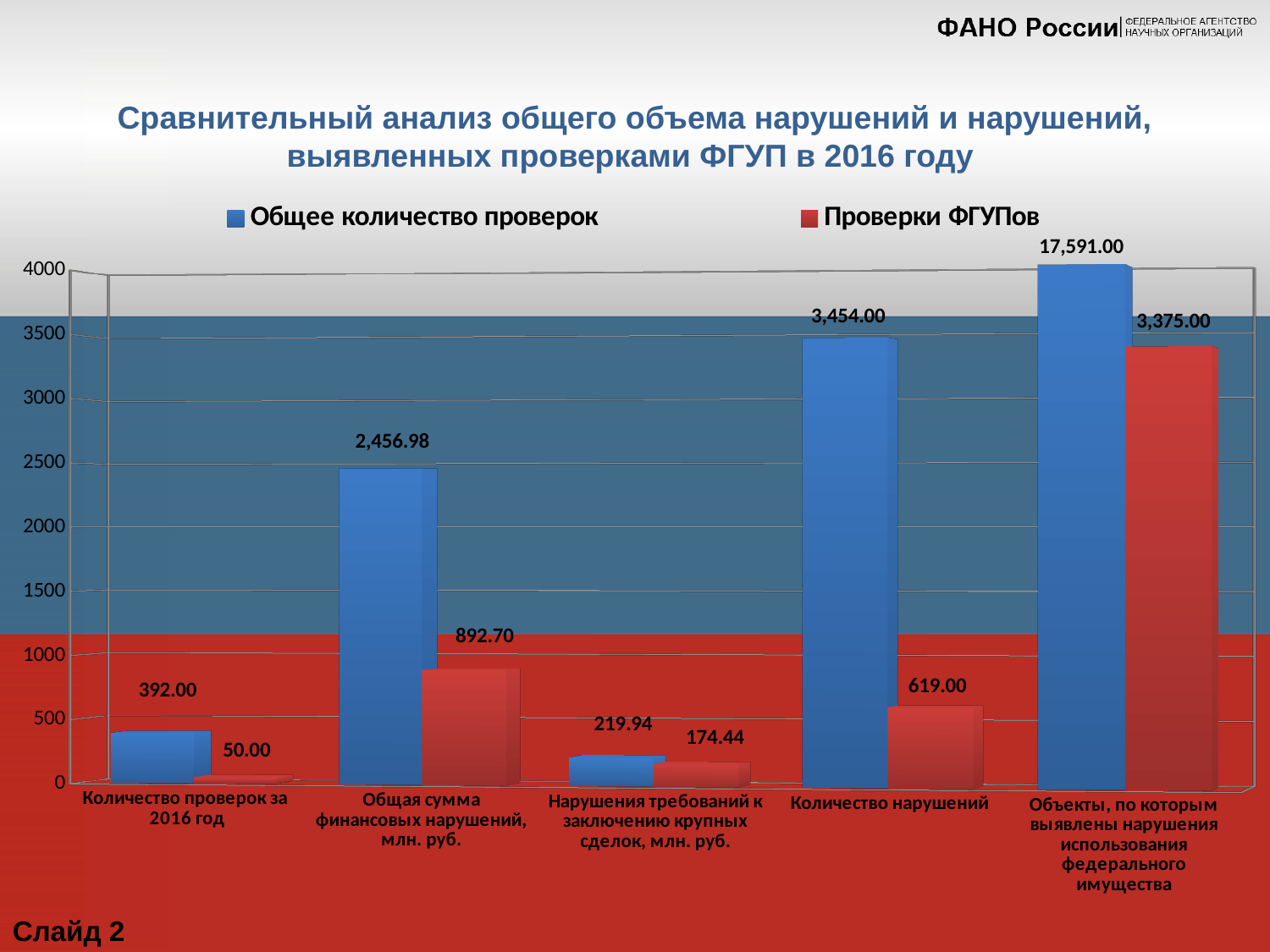
What is the value of "Общее количество проверок" for "Объекты, по которым выявлены нарушения использования федерального имущества"? 17,591.00 How many categories are shown on the x axis? 5 Which is larger for "Нарушения требований к заключению крупных сделок, млн. руб.": "Общее количество проверок" or "Проверки ФГУПов"? Общее количество проверок How many series does the legend list? 2 What is the value of "Общее количество проверок" for "Количество проверок за 2016 год"? 392.00 What is the difference between "Общее количество проверок" and "Проверки ФГУПов" for "Количество проверок за 2016 год"? 342.00 What is the difference between "Общее количество проверок" and "Проверки ФГУПов" for "Количество нарушений"? 2,835.00 What is the value of "Проверки ФГУПов" for "Общая сумма финансовых нарушений, млн. руб."? 892.70 What is the value of "Проверки ФГУПов" for "Количество нарушений"? 619.00 Which category has the highest value for "Общее количество проверок"? Объекты, по которым выявлены нарушения использования федерального имущества Which category has the lowest value for "Проверки ФГУПов"? Количество проверок за 2016 год What kind of chart is shown on the slide? Bar chart